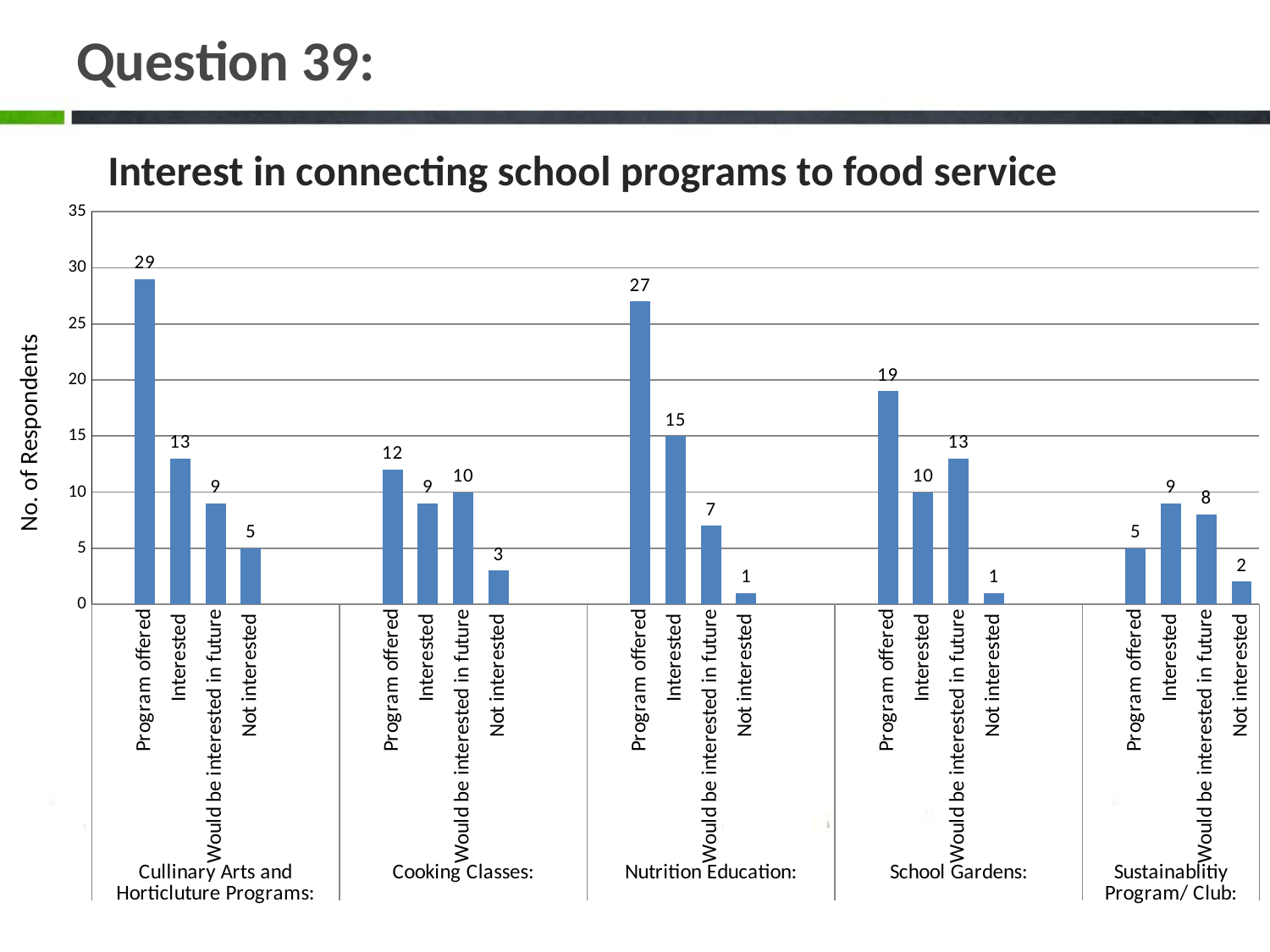
What is the value for "Would be interested in future" under Nutrition Education? 7 Is the "Program offered" value for School Gardens greater or less than 15? greater Which is larger for School Gardens: "Interested" or "Would be interested in future"? Would be interested in future What is the difference between "Program offered" and "Interested" for Nutrition Education? 12 What is the title of the chart? Interest in connecting school programs to food service What is the label of the vertical axis? No. of Respondents How many respondents said "Program offered" for Cullinary Arts and Horticluture Programs? 29 How many respondents were "Not interested" in the Sustainablitiy Program/ Club? 2 Which program group has the highest "Program offered" value? Cullinary Arts and Horticluture Programs Which program group has the lowest "Program offered" value? Sustainablitiy Program/ Club How many program groups are shown on the x axis? 5 What kind of chart is shown on the slide? Bar chart